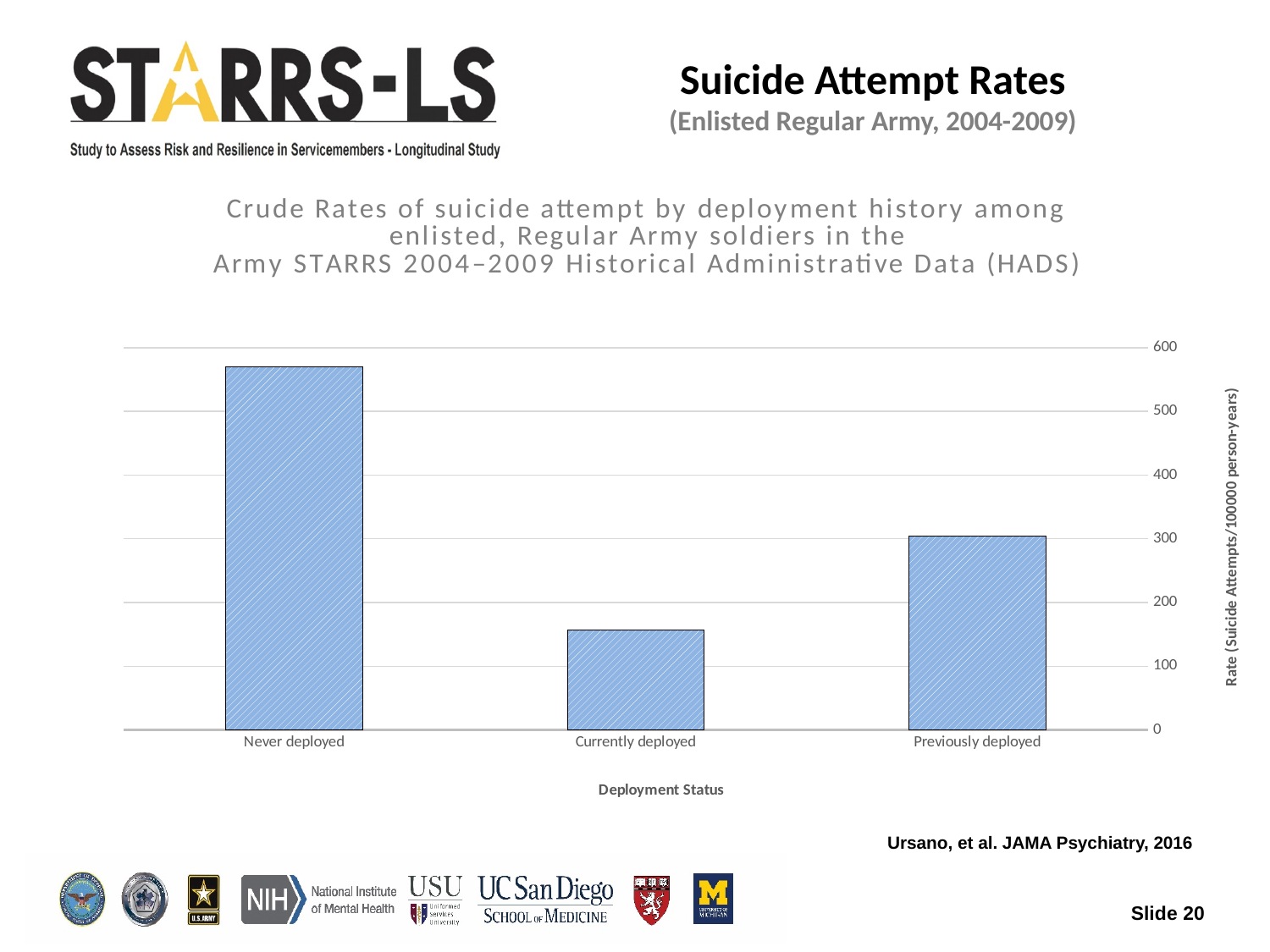
What is the title of the x axis of the chart? Deployment Status Which deployment status has the highest suicide attempt rate? Never deployed How many deployment status categories are plotted in the chart? 3 Which deployment status has the lowest suicide attempt rate? Currently deployed Which has a higher suicide attempt rate, Never deployed or Previously deployed? Never deployed Is the rate for Previously deployed greater or less than 200? greater Is the rate for Previously deployed greater or less than 400? less Which has a higher suicide attempt rate, Currently deployed or Previously deployed? Previously deployed What is the title of the y axis of the chart? Rate (Suicide Attempts/10000 person-years) Is the rate for Currently deployed greater or less than 200? less What kind of chart is shown on the slide? bar chart